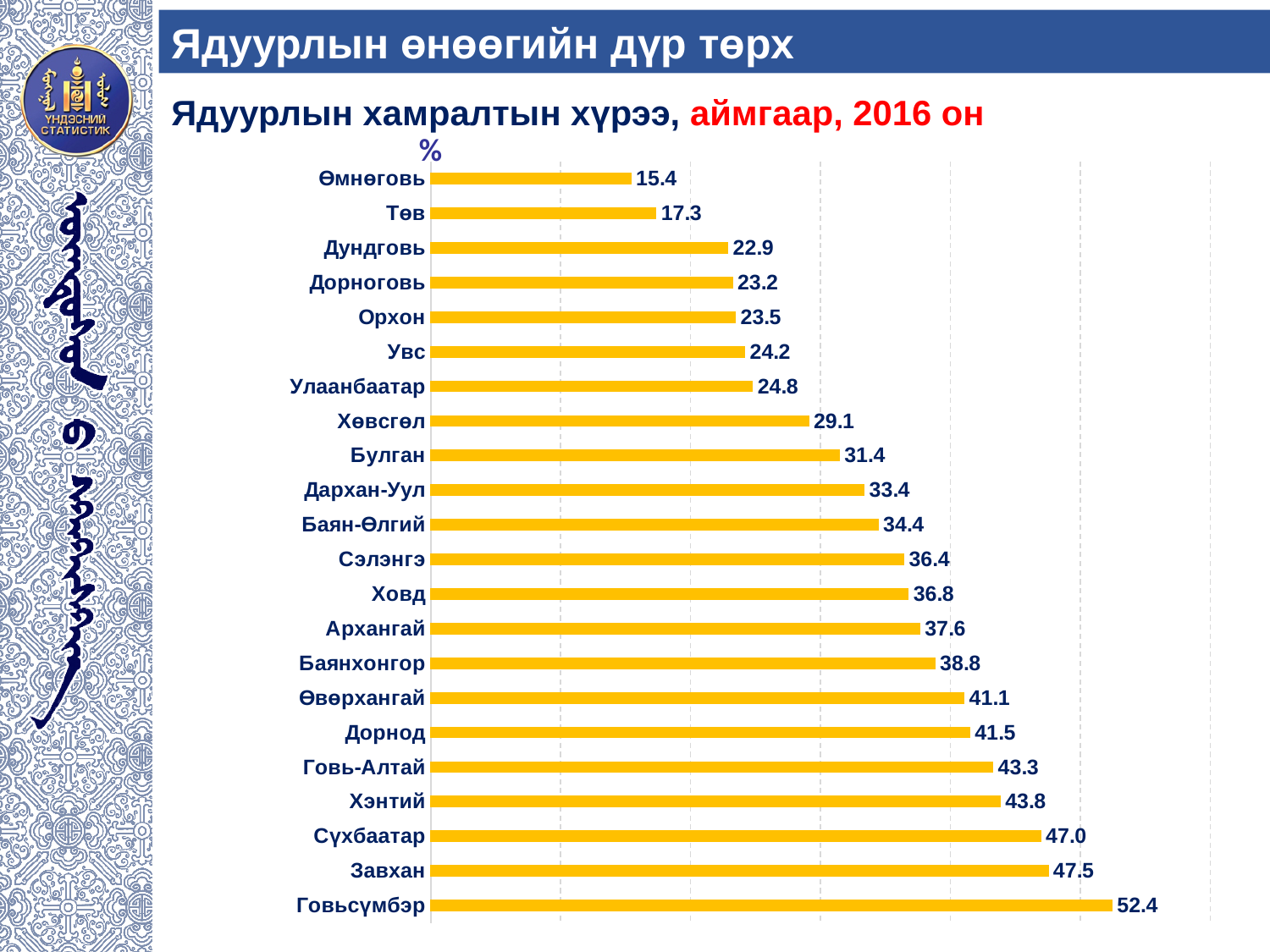
Which has a larger value, Хөвсгөл or Булган? Булган What is the title of the chart? Ядуурлын хамралтын хүрээ, аймгаар, 2016 он Which category has the highest value? Говьсүмбэр What is the value for Хэнтий? 43.8 What kind of chart is shown on the slide? Bar chart Which has a larger value, Завхан or Сүхбаатар? Завхан What is the value for Баян-Өлгий? 34.4 How many categories are shown in the chart? 22 What is the value for Улаанбаатар? 24.8 What is the difference between the values for Говьсүмбэр and Өмнөговь? 37.0 What is the difference between the values for Дорнод and Сэлэнгэ? 5.1 Which category has the lowest value? Өмнөговь